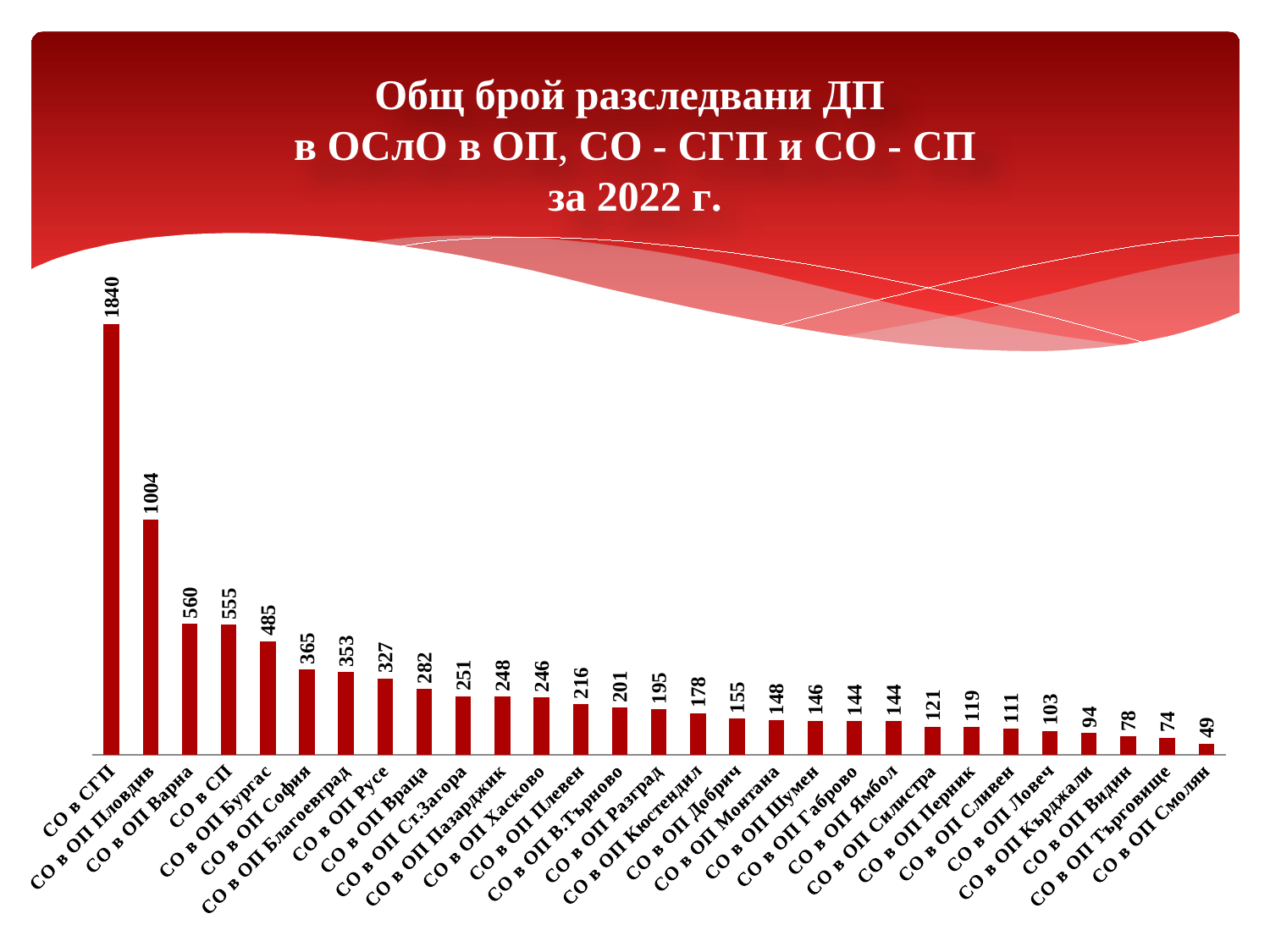
Which category has the lowest value? СО в ОП Смолян What is the value for СО в ОП Русе? 327 Which is larger, the value for СО в ОП София or the value for СО в ОП Враца? СО в ОП София How many categories are shown on the chart? 29 What is the difference between the values for СО в СГП and СО в ОП Пловдив? 836 Do the values rise or fall from left to right along the x axis? fall What is the value for СО в СГП? 1840 What is the difference between the values for СО в ОП Варна and СО в ОП Бургас? 75 What is the value for СО в ОП Кюстендил? 178 Which category has the highest value? СО в СГП What kind of chart is shown on the slide? bar chart What is the value for СО в ОП Пловдив? 1004